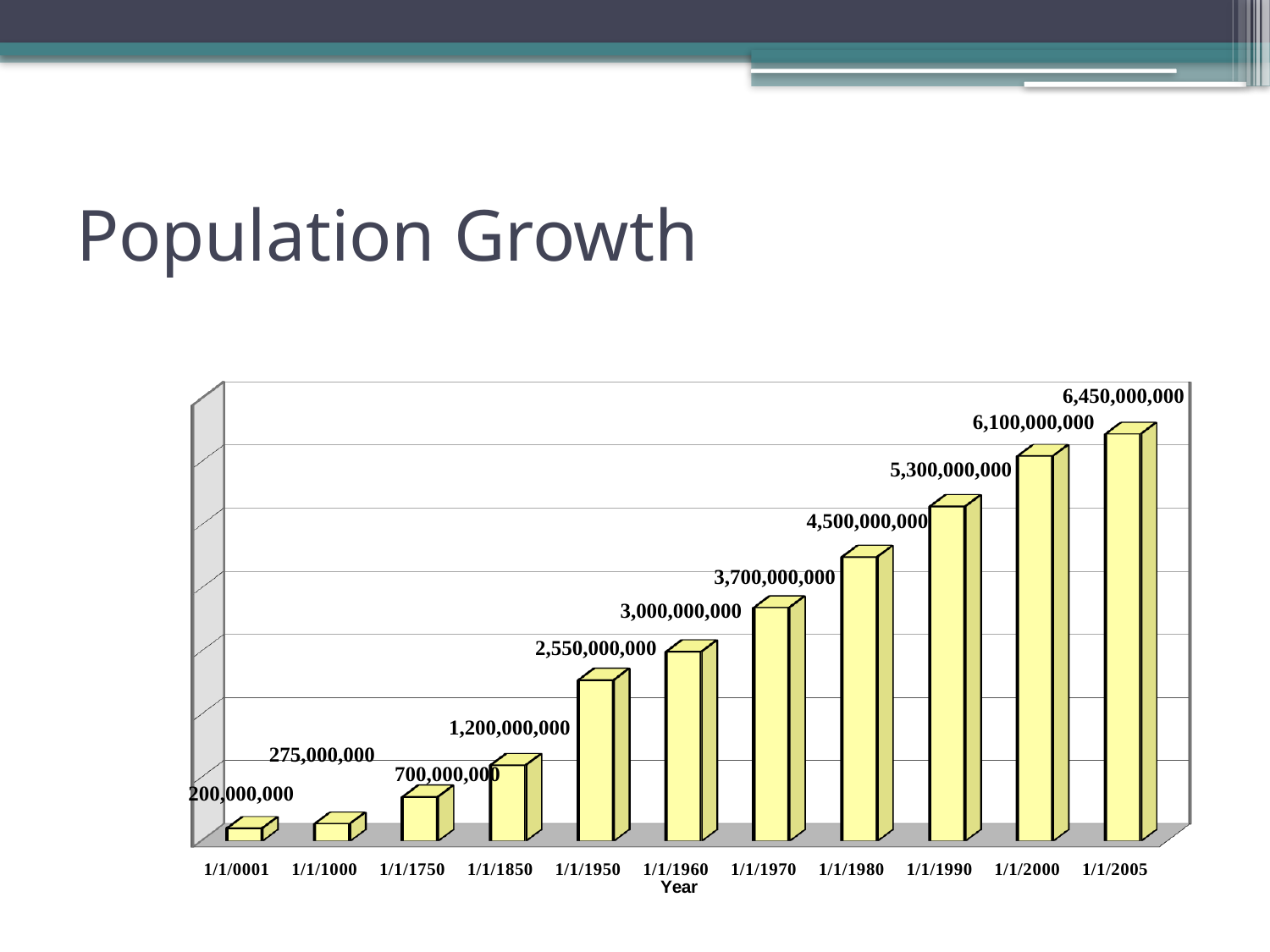
Do the values rise or fall from left to right along the x axis? rise What kind of chart is this? bar chart What is the value for 1/1/1750? 700,000,000 Which year has the lowest value? 1/1/0001 What is the difference between the values for 1/1/2005 and 1/1/2000? 350,000,000 What is the value for 1/1/1990? 5,300,000,000 What is the title of the x axis? Year Which is larger, the value for 1/1/1850 or the value for 1/1/1000? 1/1/1850 Which year has the highest value? 1/1/2005 How many years are shown on the x axis? 11 What is the difference between the values for 1/1/1970 and 1/1/1960? 700,000,000 What is the value for 1/1/1950? 2,550,000,000